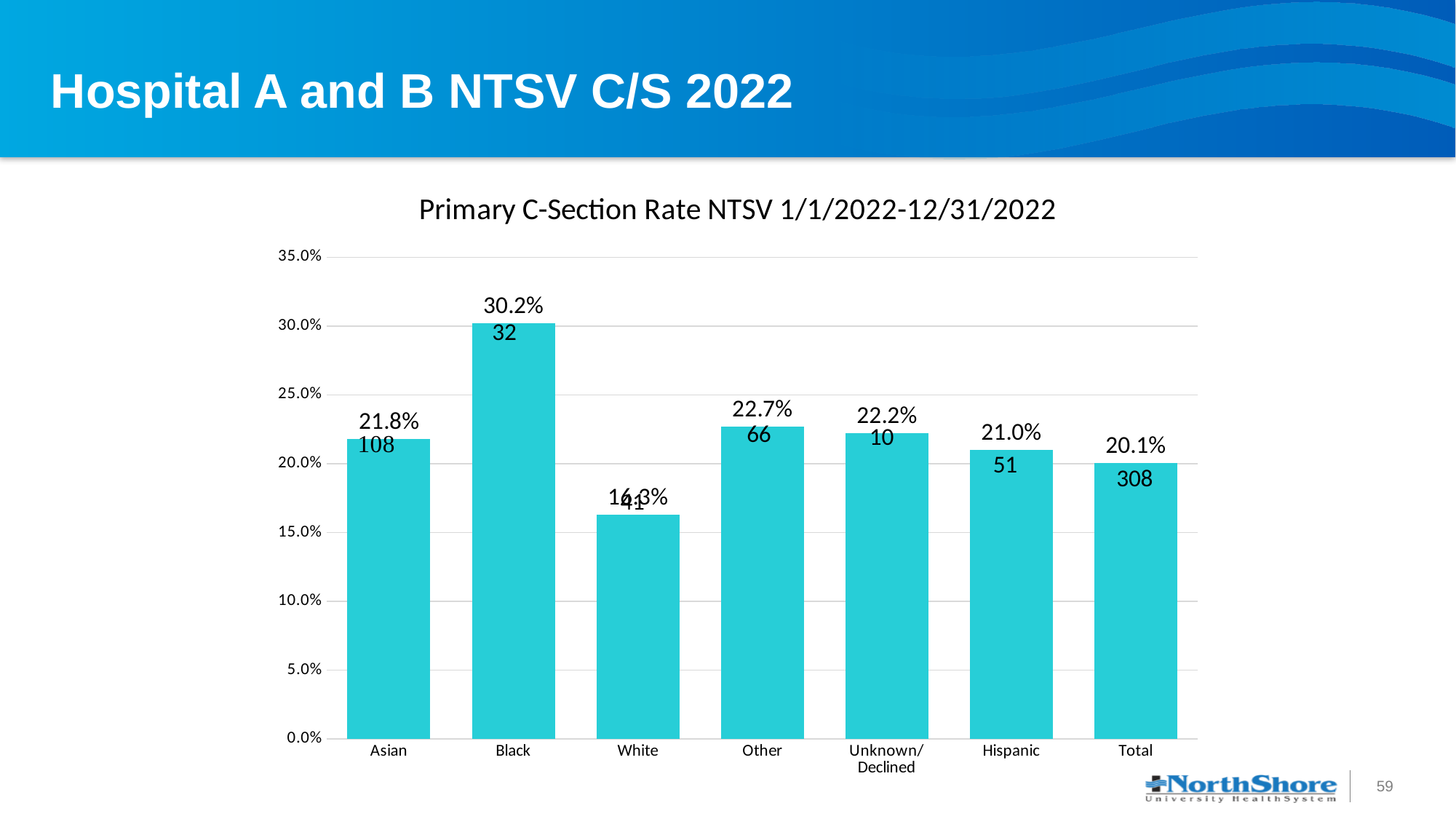
Which has a higher primary C-section rate, Other or Hispanic? Other What kind of chart is shown on the slide? Bar chart Which category has the highest primary C-section rate? Black What is the primary C-section rate for the Unknown/Declined category? 22.2% What number is printed on the Total bar below the percentage? 308 Which category has the lowest primary C-section rate? White How many percentage points higher is the rate for Black patients than for Asian patients? 8.4 percentage points What is the primary C-section rate for Black patients? 30.2% What is the primary C-section rate shown for the Total category? 20.1% Is the value for White greater or less than 20.0%? less How many categories are shown on the x axis? 7 What is the primary C-section rate for Asian patients? 21.8%